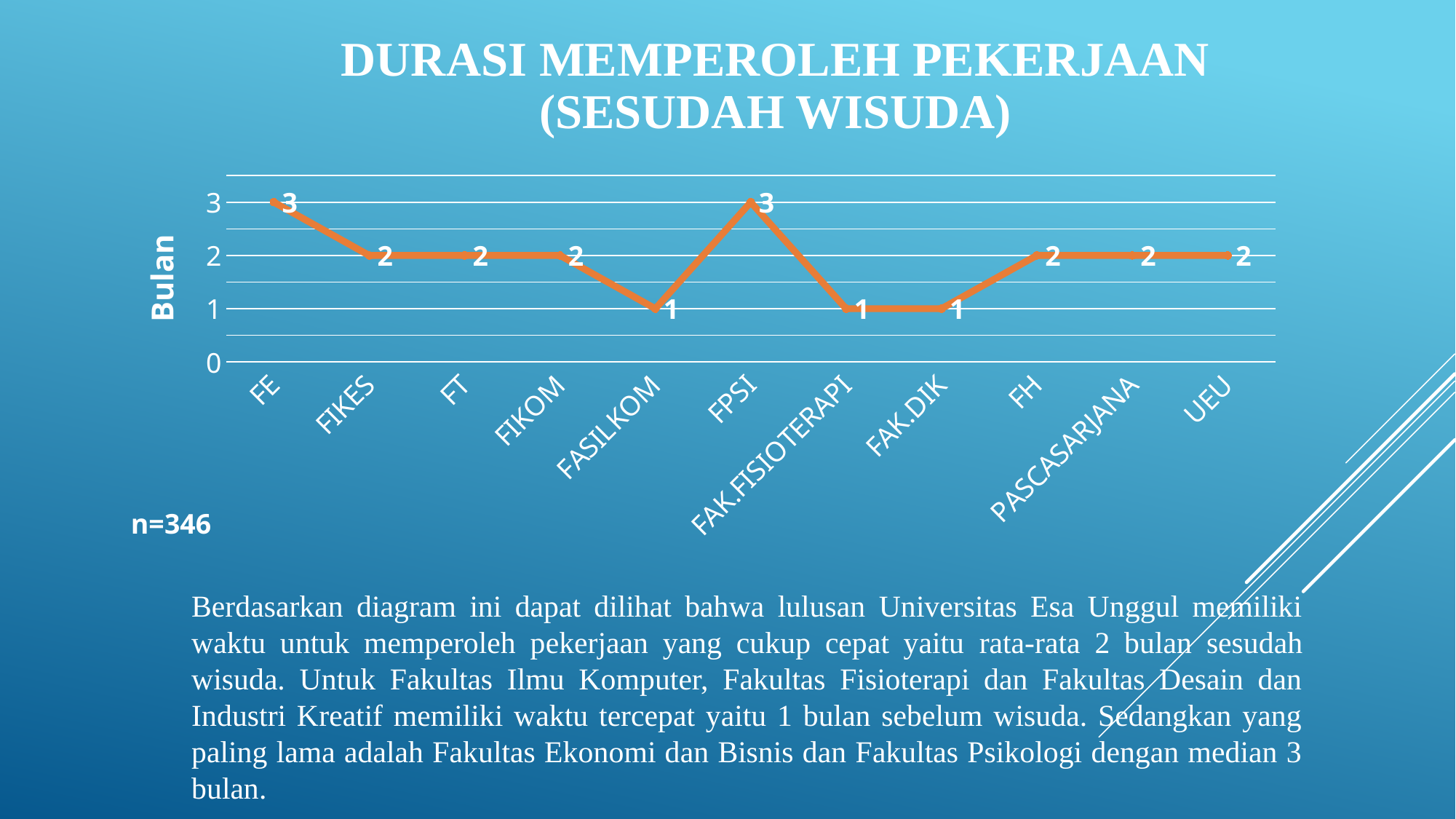
What is the value for PASCASARJANA? 2 What type of chart is shown on the slide? line chart What is the value for FPSI? 3 What is the difference between the values for FE and FIKES? 1 What is the value for FAK.FISIOTERAPI? 1 What is the highest value plotted on the chart? 3 What is the difference between the values for FPSI and FAK.DIK? 2 What is the value for FE? 3 Which has a larger value, FH or FASILKOM? FH What is the label of the vertical axis? Bulan What is the value for FASILKOM? 1 How many categories are plotted on the x axis? 11